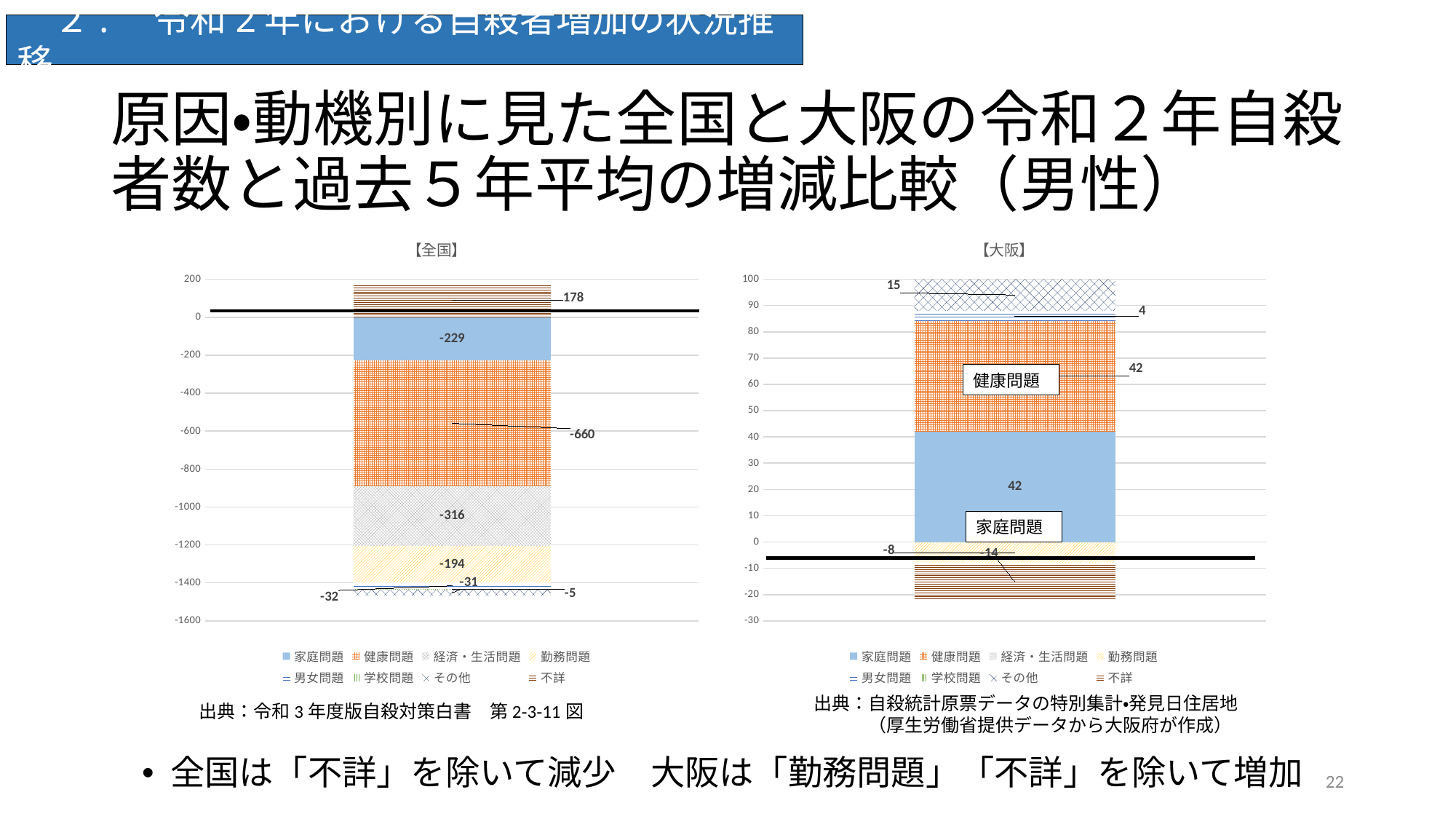
How many series does the legend of the 【全国】 chart list? 8 In the 【大阪】 chart, what is the value for 勤務問題? -8 In the 【全国】 chart, which category has the lowest (most negative) value? 健康問題 In the 【大阪】 chart, what is the value for 不詳? -14 In the 【全国】 chart, what is the value for 不詳? 178 In the 【大阪】 chart, what is the value for 健康問題? 42 In the 【全国】 chart, what is the difference between the values for 経済・生活問題 (-316) and 勤務問題 (-194)? 122 What kind of chart is used for the 【全国】 and 【大阪】 charts? Stacked bar chart In the 【全国】 chart, what is the value for 経済・生活問題? -316 In the 【全国】 chart, what is the value for 健康問題? -660 In the 【全国】 chart, what is the value for 家庭問題? -229 In the 【大阪】 chart, what is the value for 家庭問題? 42